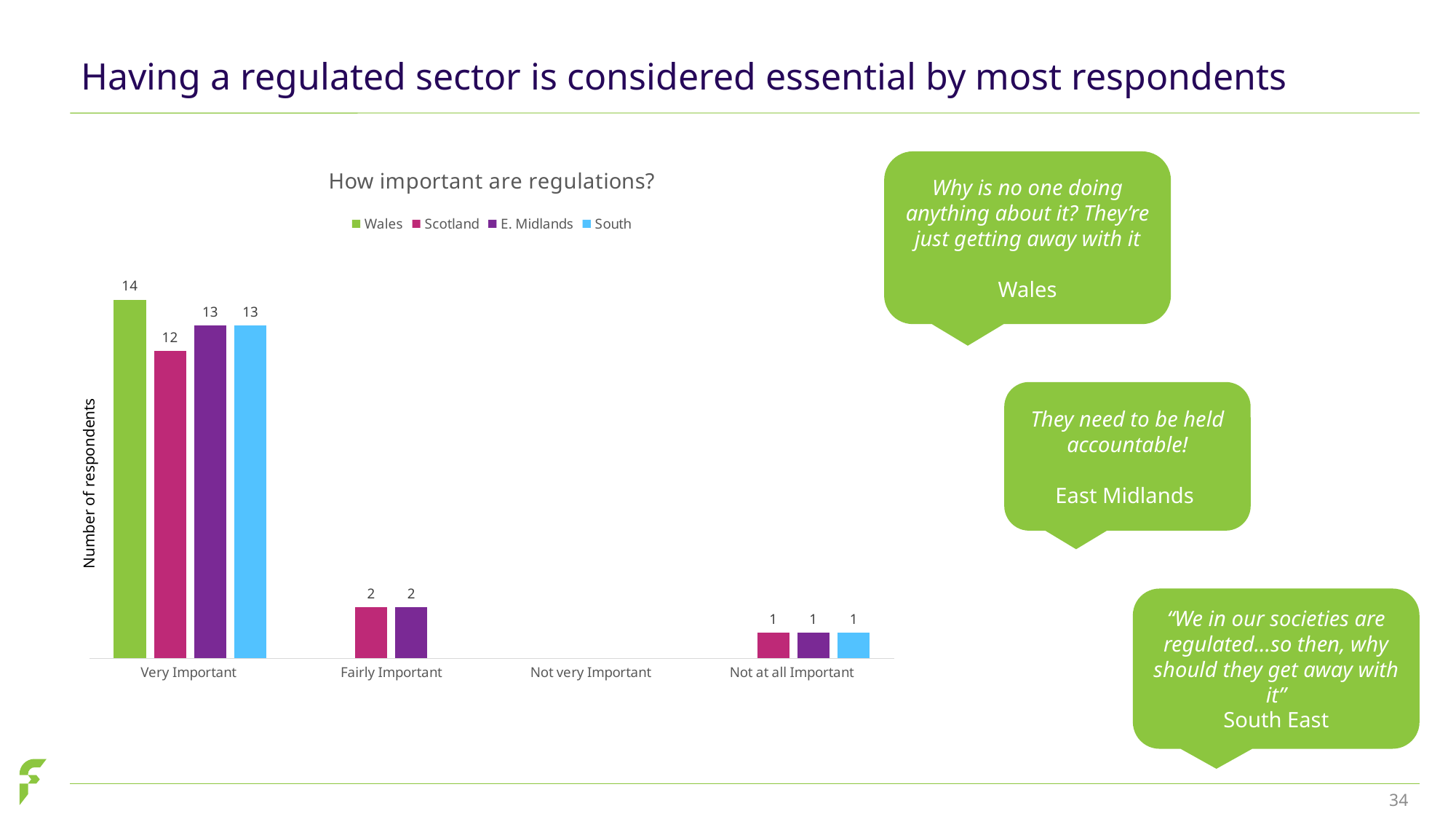
What is the value for Scotland in the Very Important category? 12 Which is larger in the Very Important category: the value for E. Midlands or the value for Scotland? E. Midlands Which series has the highest value in the Very Important category? Wales What is the title of the chart? How important are regulations? What is the value for E. Midlands in the Fairly Important category? 2 What is the difference between the Wales and Scotland values in the Very Important category? 2 How many categories are shown on the x axis? 4 What is the value for Wales in the Very Important category? 14 How many series does the legend list? 4 What kind of chart is shown on the slide? Bar chart Which series has the lowest value in the Very Important category? Scotland What is the value for South in the Not at all Important category? 1